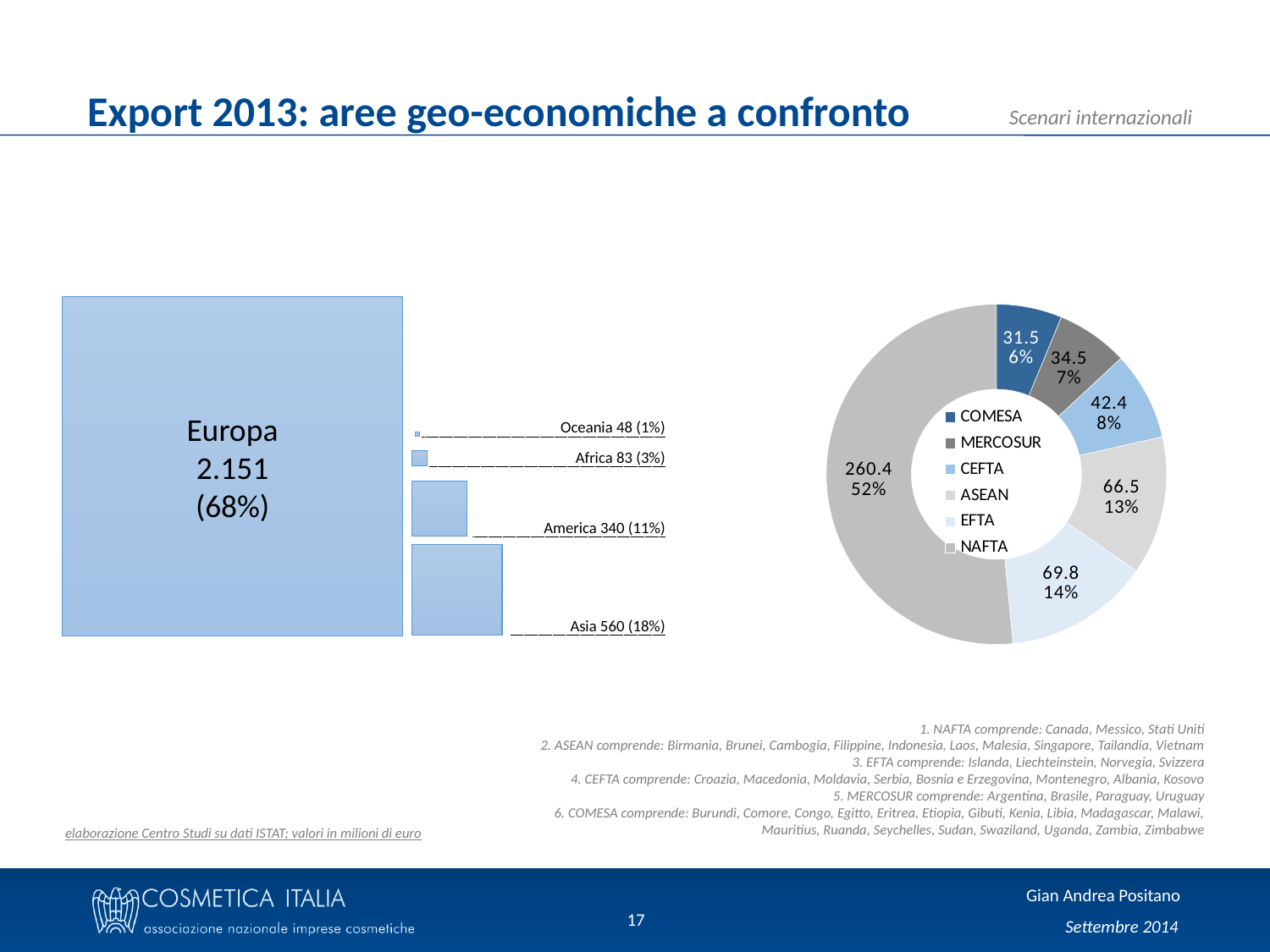
How many entries does the legend of the right doughnut chart list? 6 In the right doughnut chart, what value is shown for NAFTA? 260.4 In the right doughnut chart, which area has the smallest value? COMESA In the left chart, which area has the lowest export value? Oceania In the right doughnut chart, what is the difference between the values for NAFTA and EFTA? 190.6 What kind of chart is the chart on the right of the slide? doughnut chart In the left chart, what is the export value shown for Europa? 2.151 In the left chart, what is the difference between the values for Asia and America? 220 In the left chart, what percentage share is shown for Asia? 18% In the left chart, how many geographic areas are shown? 5 In the right doughnut chart, which is larger, EFTA or ASEAN? EFTA In the right doughnut chart, what percentage share does NAFTA hold? 52%